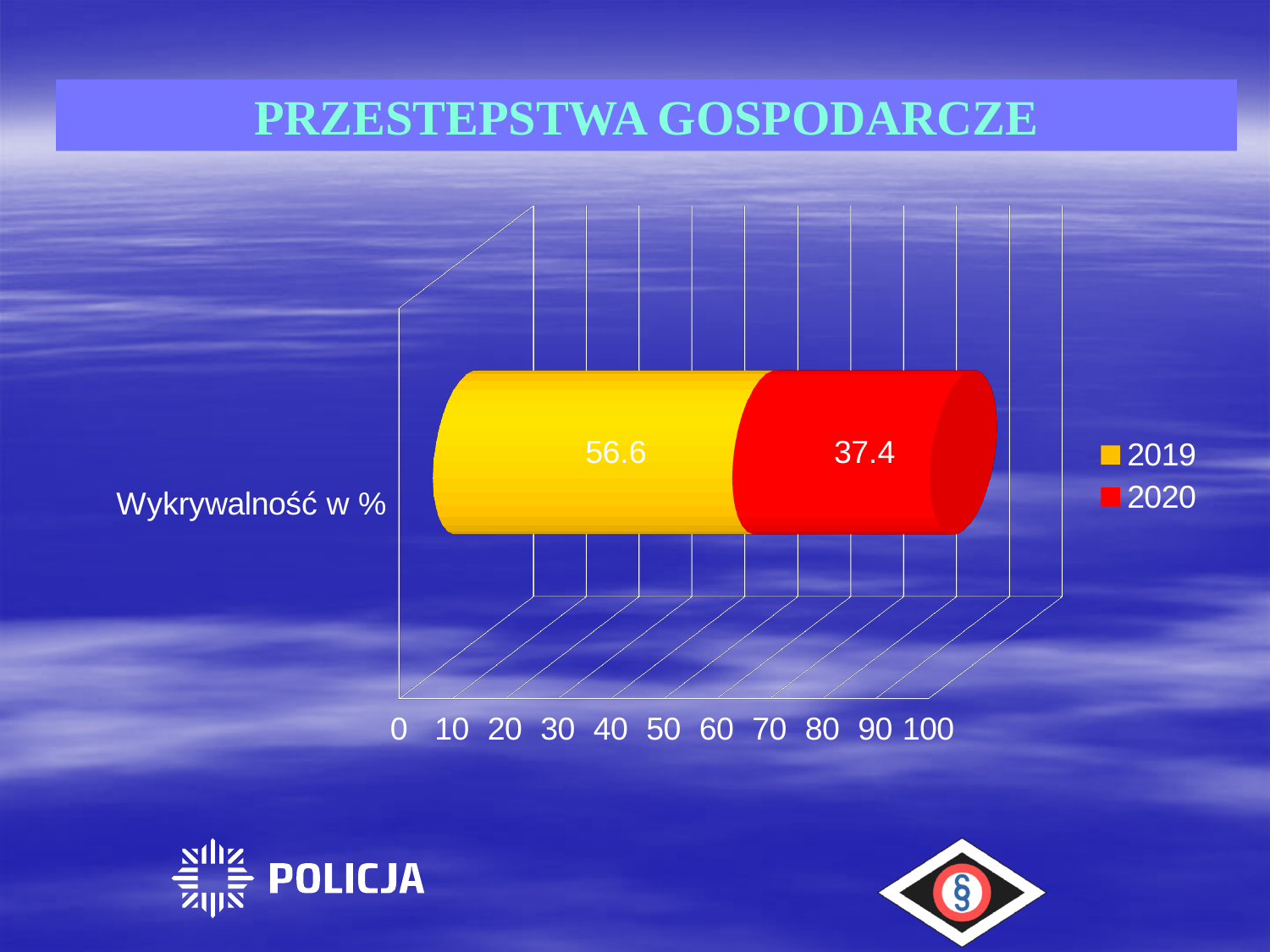
What is the value for 2020 in the chart? 37.4 What is the total of the stacked bar for Wykrywalność w %? 94 Which series has the higher value, 2019 or 2020? 2019 What colour represents the 2020 series in the chart? Red What is the title of the slide containing the chart? PRZESTEPSTWA GOSPODARCZE What is the value for 2019 in the chart? 56.6 What is the difference between the 2019 value and the 2020 value? 19.2 Which series has the lowest value in the chart? 2020 How many categories are plotted in the chart? 1 What kind of chart is shown on the slide? Stacked bar chart Which series has the highest value in the chart? 2019 How many series does the legend list? 2